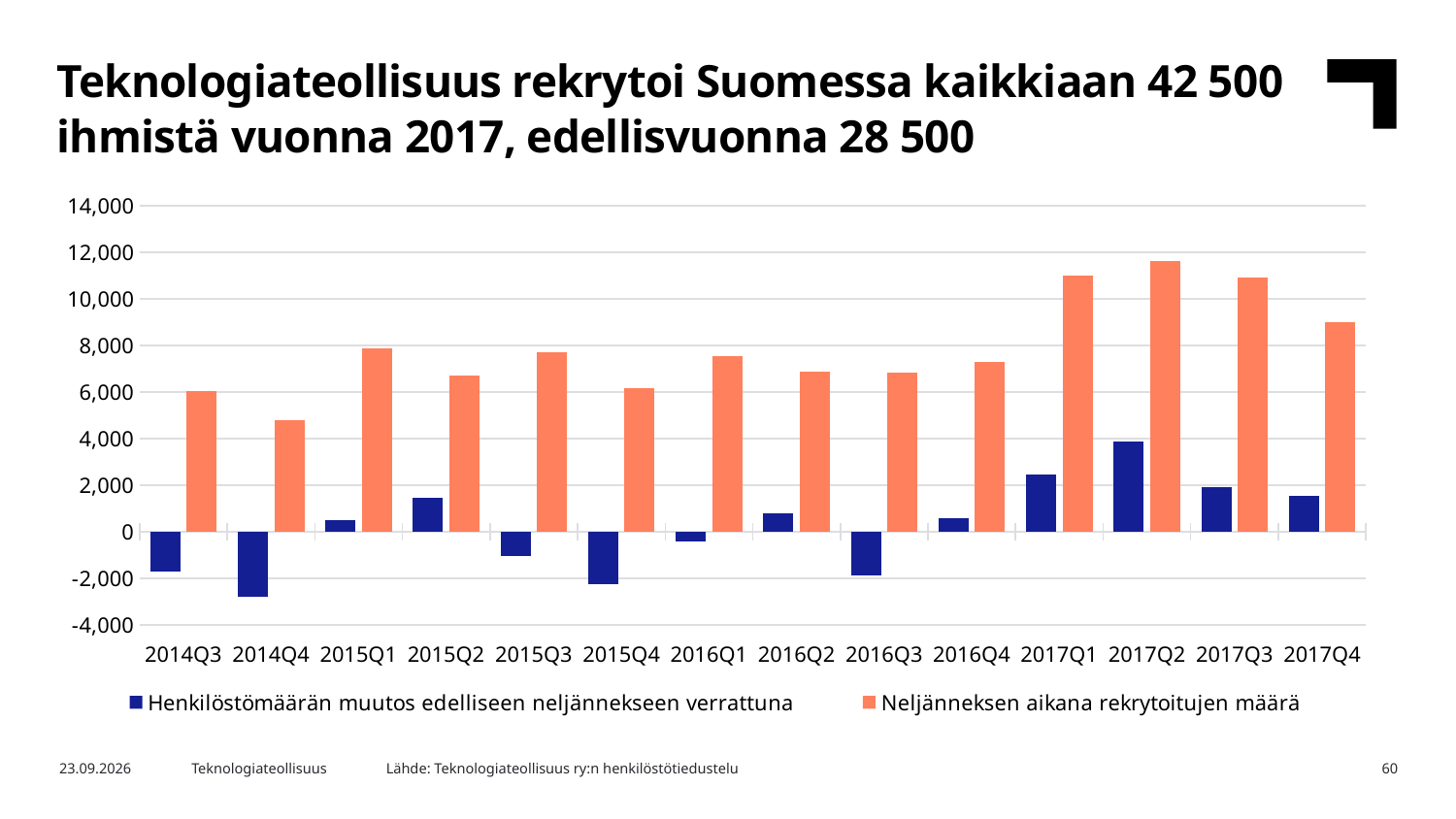
Which quarter has the larger value for 'Neljänneksen aikana rekrytoitujen määrä', 2016Q1 or 2017Q1? 2017Q1 In which quarter is the value for 'Neljänneksen aikana rekrytoitujen määrä' highest? 2017Q2 How many series does the chart legend list? 2 How many quarters are shown on the x axis of the chart? 14 Is the value for 'Neljänneksen aikana rekrytoitujen määrä' in 2017Q1 greater or less than 10,000? greater Is the value for 'Neljänneksen aikana rekrytoitujen määrä' in 2014Q4 greater or less than 6,000? less Is the value for 'Henkilöstömäärän muutos edelliseen neljännekseen verrattuna' in 2014Q4 greater or less than -2,000? less In which quarter is the value for 'Henkilöstömäärän muutos edelliseen neljännekseen verrattuna' highest? 2017Q2 What kind of chart is shown on the slide? bar chart In which quarter is the value for 'Neljänneksen aikana rekrytoitujen määrä' lowest? 2014Q4 In which quarter is the value for 'Henkilöstömäärän muutos edelliseen neljännekseen verrattuna' lowest? 2014Q4 Which colour represents 'Neljänneksen aikana rekrytoitujen määrä' in the chart? orange